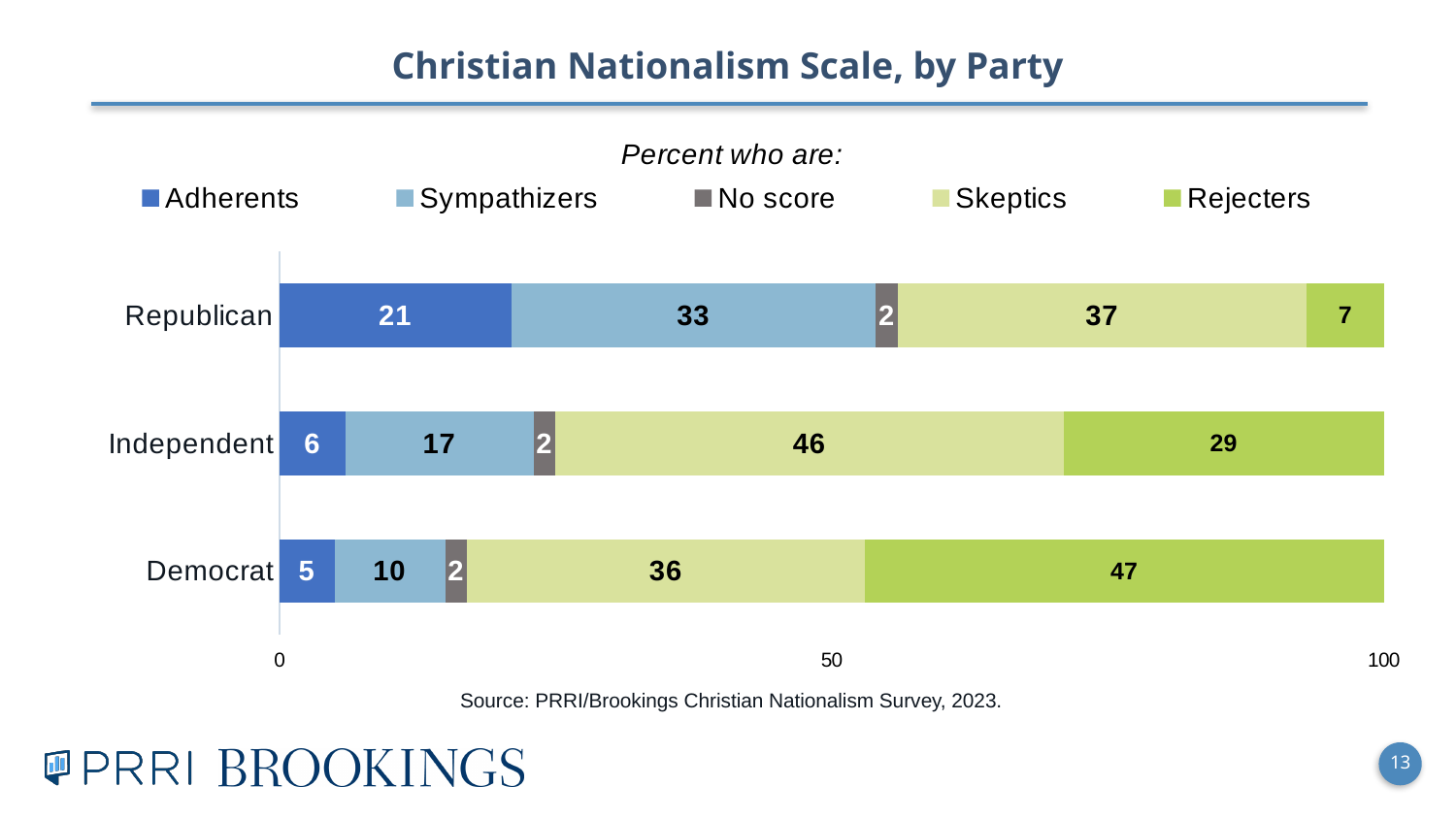
How many parties are shown on the chart? 3 What is the total of the Republican bar? 100 How many series does the legend list? 5 What percent of Republicans are Adherents? 21 What percent of Democrats are Rejecters? 47 What is the difference between the percent of Rejecters among Democrats and among Republicans? 40 What percent of Independents are Skeptics? 46 What is the title of the chart? Christian Nationalism Scale, by Party Which party has the lowest percent of Adherents? Democrat Which is larger: the percent of Skeptics among Independents or among Democrats? Independents Which party has the highest percent of Sympathizers? Republican What kind of chart is shown on the slide? Stacked bar chart